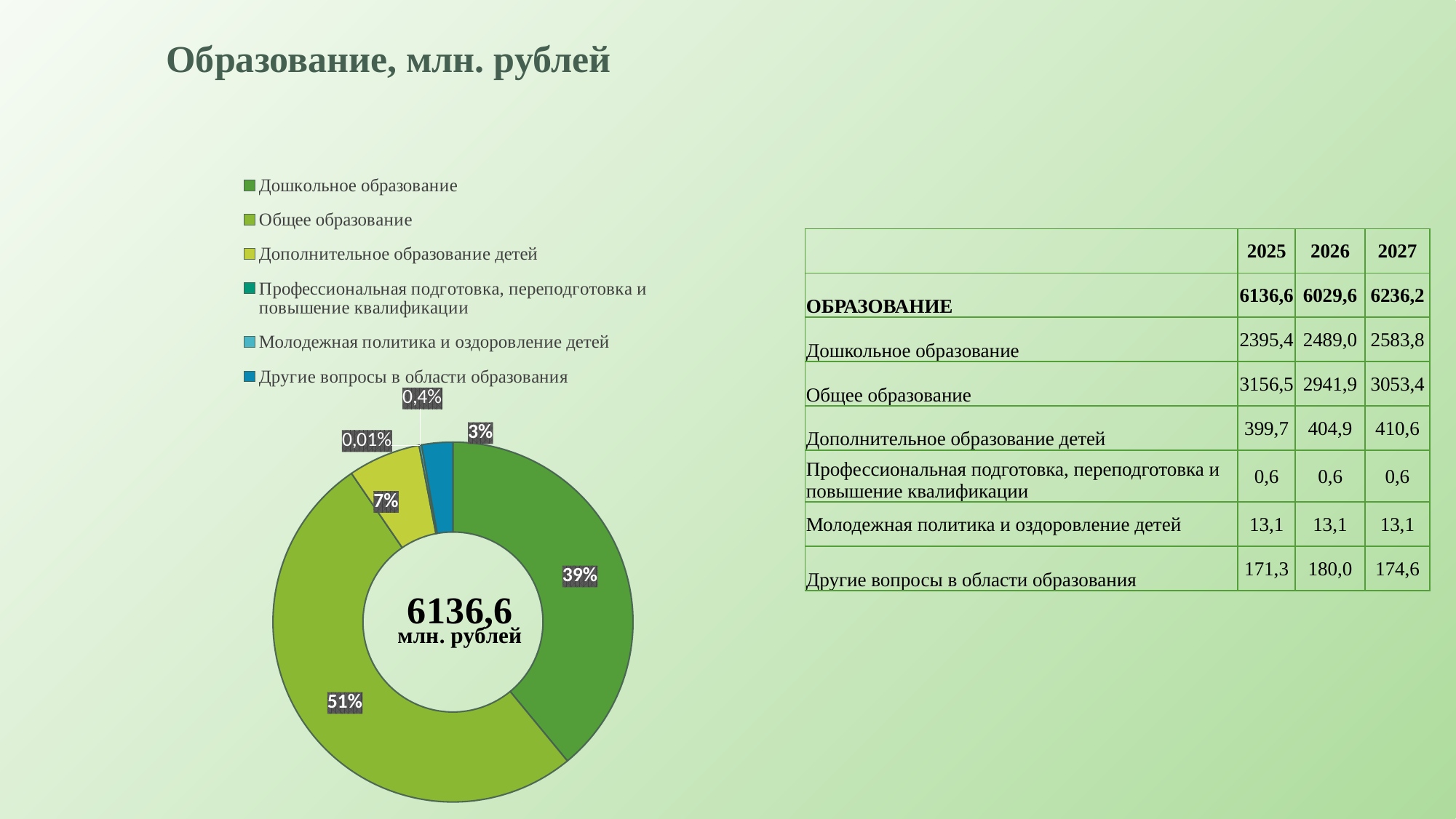
Which category has the largest share of the doughnut chart? Общее образование What total value is printed in the centre of the doughnut chart? 6136,6 млн. рублей What share of the doughnut chart does Общее образование account for? 51% What percentage label is shown for Другие вопросы в области образования on the doughnut chart? 3% What percentage label is shown for Молодежная политика и оздоровление детей on the doughnut chart? 0,4% By how many percentage points does the share of Общее образование exceed the share of Дошкольное образование? 12% Which has a larger share of the doughnut chart: Дополнительное образование детей or Другие вопросы в области образования? Дополнительное образование детей What percentage label is shown for Профессиональная подготовка, переподготовка и повышение квалификации on the doughnut chart? 0,01% What share of the doughnut chart does Дошкольное образование account for? 39% Which category has the smallest share of the doughnut chart? Профессиональная подготовка, переподготовка и повышение квалификации What percentage label is shown for Дополнительное образование детей on the doughnut chart? 7% How many categories does the legend of the doughnut chart list? 6